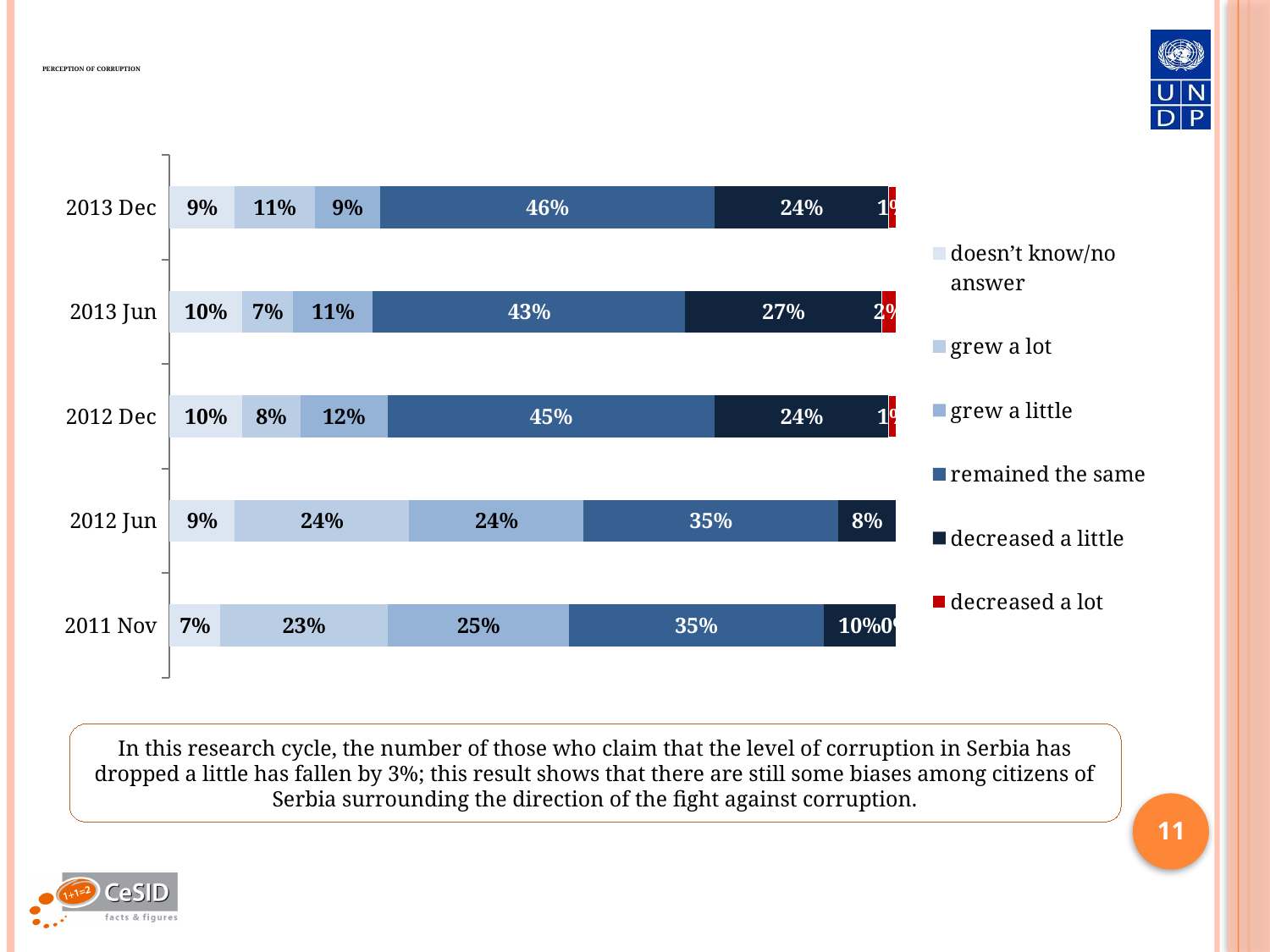
What percentage of respondents in 2013 Dec said corruption remained the same? 46% What kind of chart is shown on the slide? Stacked bar chart What is the value for 'decreased a little' in 2013 Jun? 27% What is the value for 'grew a lot' in 2012 Jun? 24% Which period has the lowest value for 'doesn't know/no answer'? 2011 Nov Which period has the larger 'remained the same' value, 2012 Dec or 2012 Jun? 2012 Dec What is the value for 'grew a little' in 2011 Nov? 25% Which period has the highest value for 'remained the same'? 2013 Dec What is the difference between the 'decreased a little' values for 2013 Jun and 2013 Dec? 3% What colour represents 'decreased a lot' in the legend? Red How many time periods are shown on the chart? 5 How many series does the legend list? 6